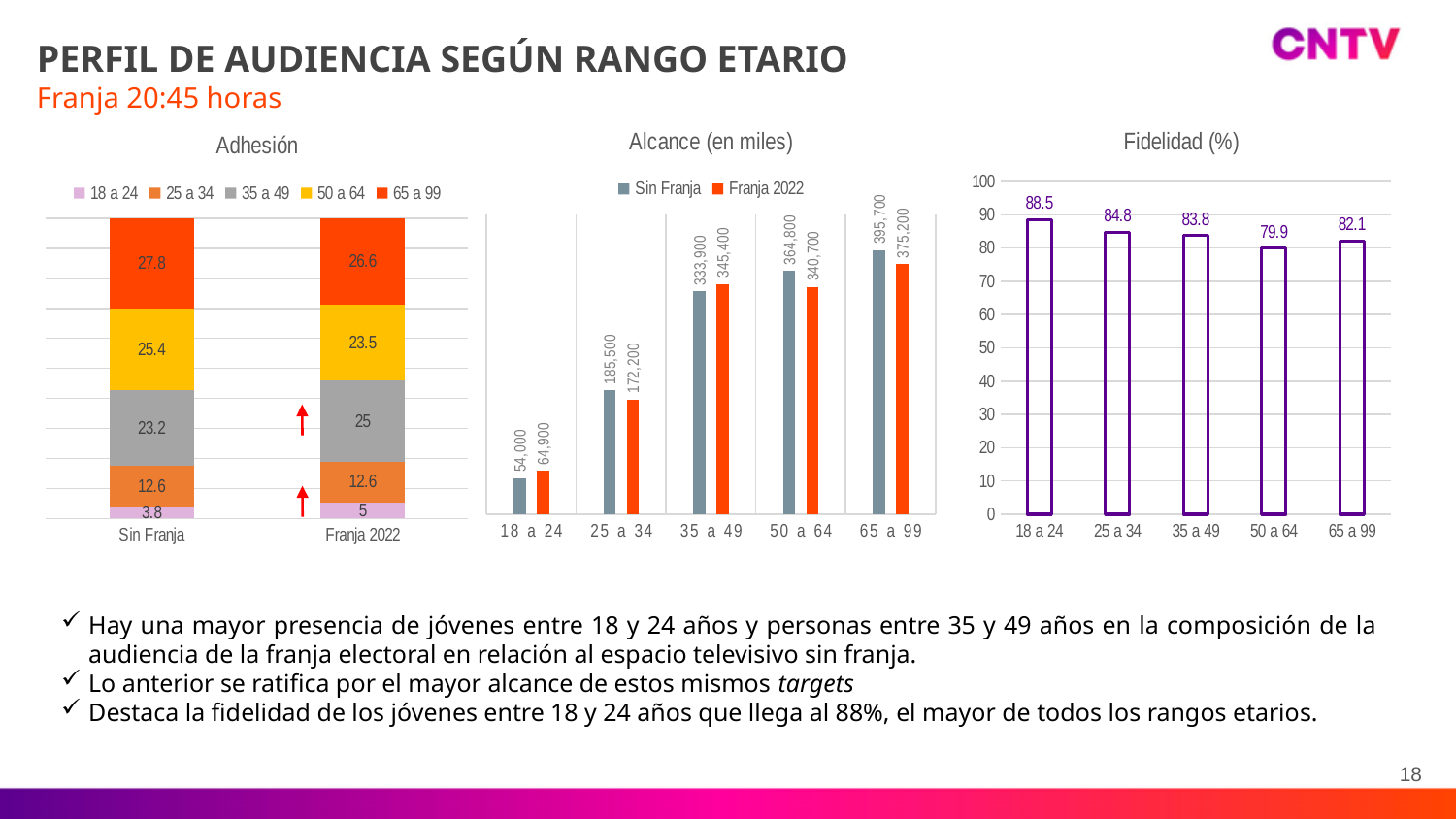
In the Alcance (en miles) chart, what is the difference between the Sin Franja and Franja 2022 values for 25 a 34? 13,300 In the Fidelidad (%) chart, what is the value for 25 a 34? 84.8 In the Adhesión chart, what is the value of the 35 a 49 segment for Franja 2022? 25 In the Adhesión chart, what is the difference between the 18 a 24 values for Franja 2022 and Sin Franja? 1.2 In the Fidelidad (%) chart, which category has the lowest value? 50 a 64 In the Adhesión chart, how many series does the legend list? 5 In the Alcance (en miles) chart, what is the Sin Franja value for 65 a 99? 395,700 In the Alcance (en miles) chart, which category has the highest Sin Franja value? 65 a 99 What kind of chart is the Fidelidad (%) chart? Bar chart In the Alcance (en miles) chart, what is the Franja 2022 value for 18 a 24? 64,900 In the Alcance (en miles) chart, which is larger for 50 a 64: Sin Franja or Franja 2022? Sin Franja In the Adhesión chart, what is the value of the 65 a 99 segment for Sin Franja? 27.8